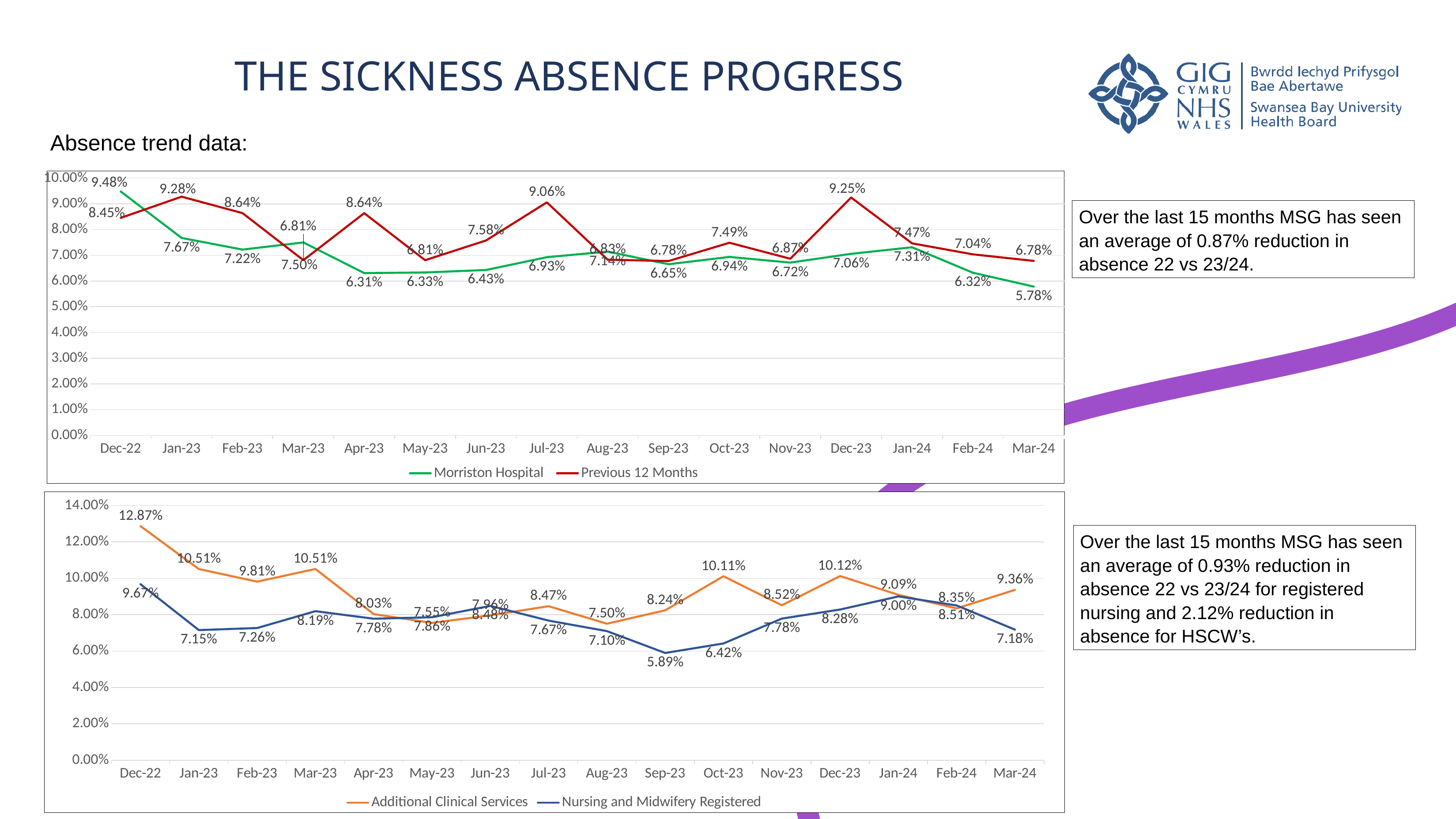
In the top chart, what is the difference between the Morriston Hospital values for Dec-22 and Mar-24? 3.70% In the top chart, what is the Morriston Hospital value for Mar-24? 5.78% In the bottom chart, what is the Additional Clinical Services value for Dec-22? 12.87% In the bottom chart, which month has the lowest Nursing and Midwifery Registered value? Sep-23 What kind of chart is the bottom chart? Line chart In the bottom chart, what is the difference between the Additional Clinical Services and Nursing and Midwifery Registered values for Mar-24? 2.18% In the bottom chart, which is larger for Oct-23: Additional Clinical Services or Nursing and Midwifery Registered? Additional Clinical Services In the top chart, what is the Previous 12 Months value for Dec-23? 9.25% In the top chart, which month has the lowest Morriston Hospital value? Mar-24 In the top chart, how many series does the legend list? 2 In the top chart, which month has the highest Morriston Hospital value? Dec-22 In the bottom chart, how many months are shown on the x axis? 16